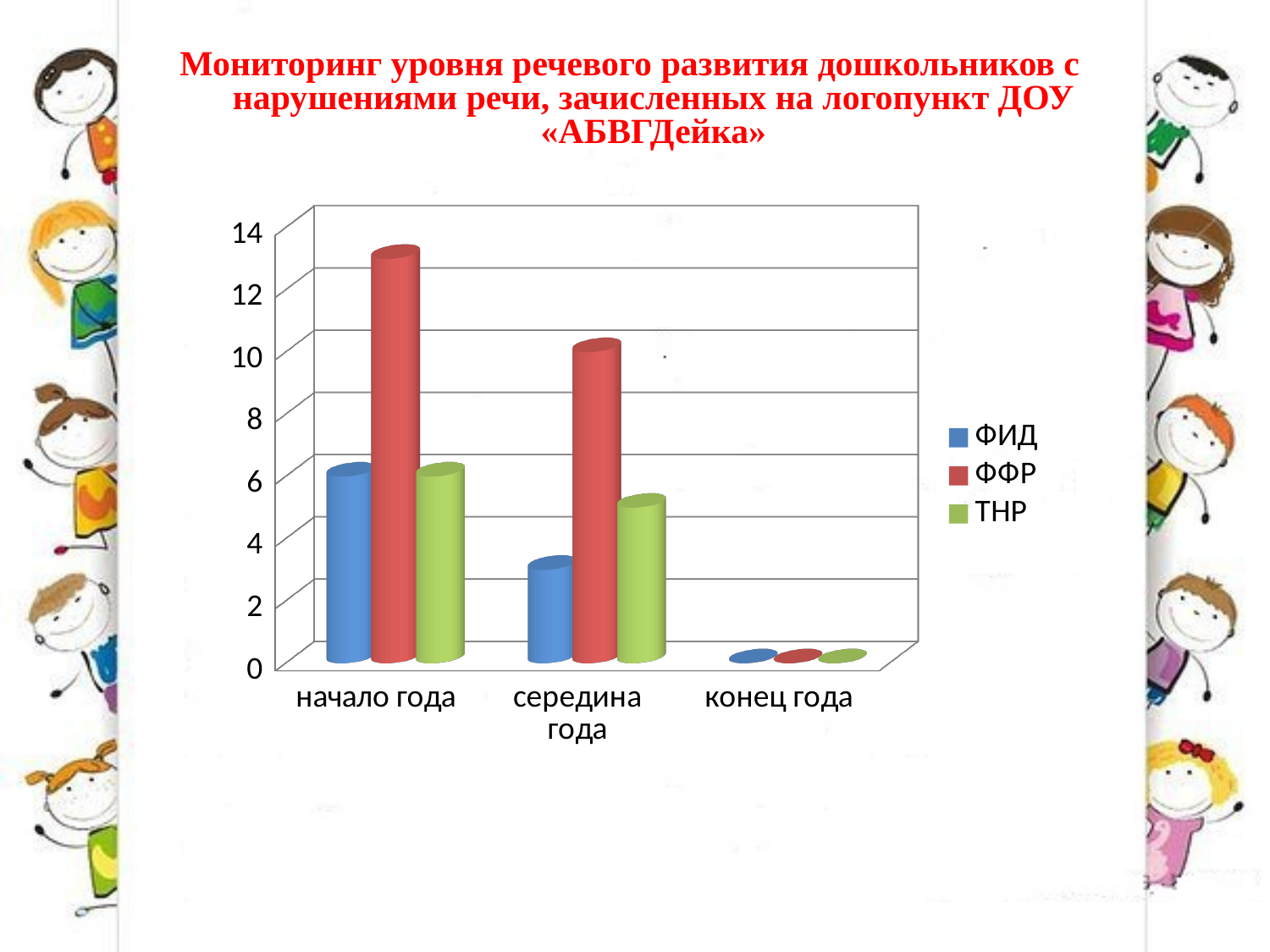
What kind of chart is shown on the slide? bar chart Which category has the lowest values for all three series? конец года How many categories are shown on the x axis? 3 For середина года, which is larger: ФФР or ФИД? ФФР Is the value for ФФР at середина года greater or less than 8? greater Is the value for ТНР at начало года greater or less than 4? greater How many series does the legend list? 3 Do the values for ФФР rise or fall from начало года to конец года? fall What colour represents the ФФР series? red Which series has the highest value for начало года? ФФР Is the value for ФФР at начало года greater or less than 12? greater